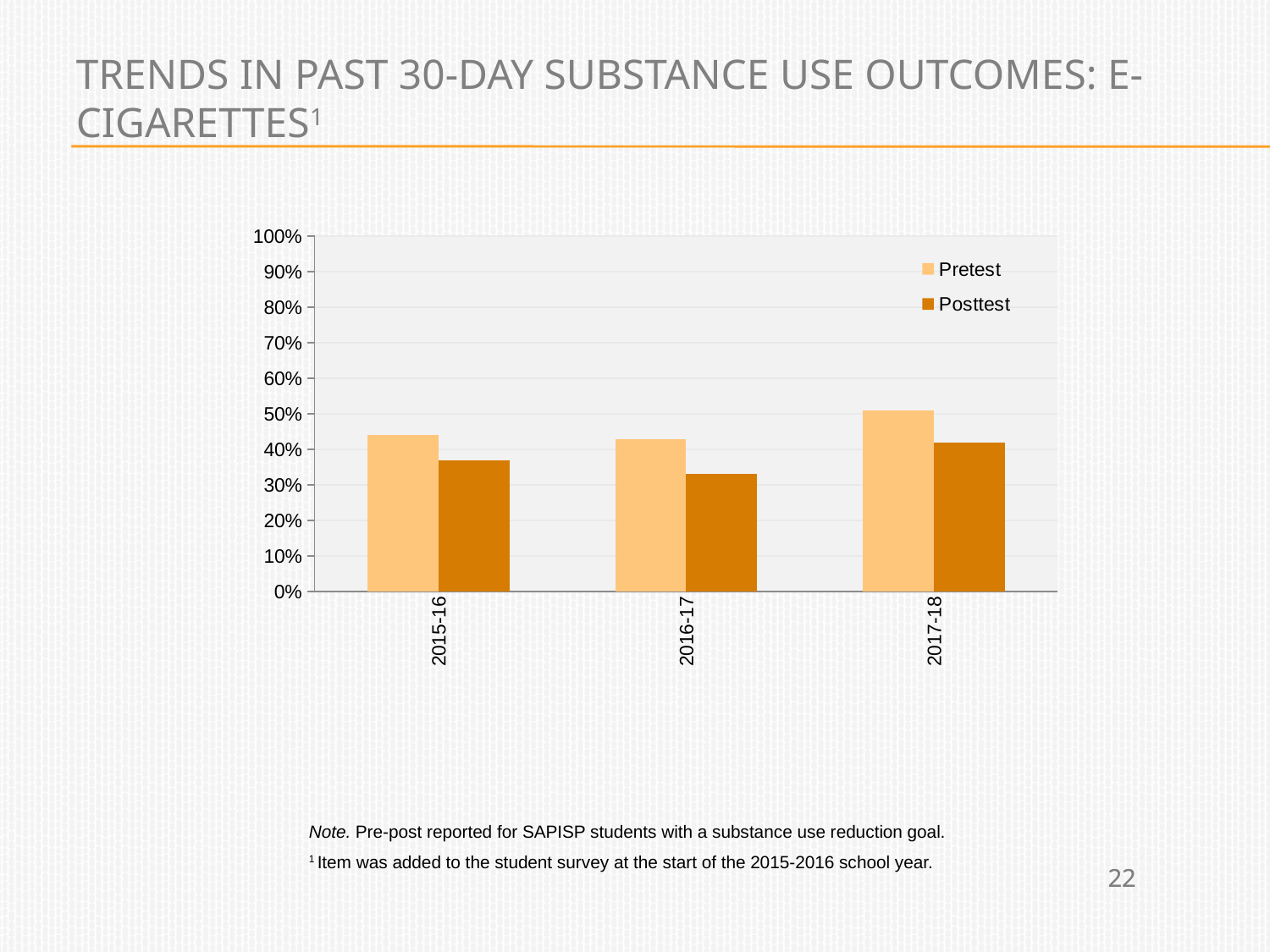
Is the Posttest value for 2017-18 greater or less than 50%? less What kind of chart is shown on the slide? bar chart For 2015-16, which is larger, the Pretest value or the Posttest value? Pretest Which series is shown in the darker orange colour? Posttest Which is larger, the Posttest value for 2017-18 or the Posttest value for 2016-17? 2017-18 Is the Pretest value for 2015-16 greater or less than 40%? greater Which school year has the highest Pretest value? 2017-18 How many school years are shown on the x axis? 3 Which school year has the highest Posttest value? 2017-18 Which school year has the lowest Posttest value? 2016-17 Is the Posttest value for 2016-17 greater or less than 40%? less How many series does the legend list? 2